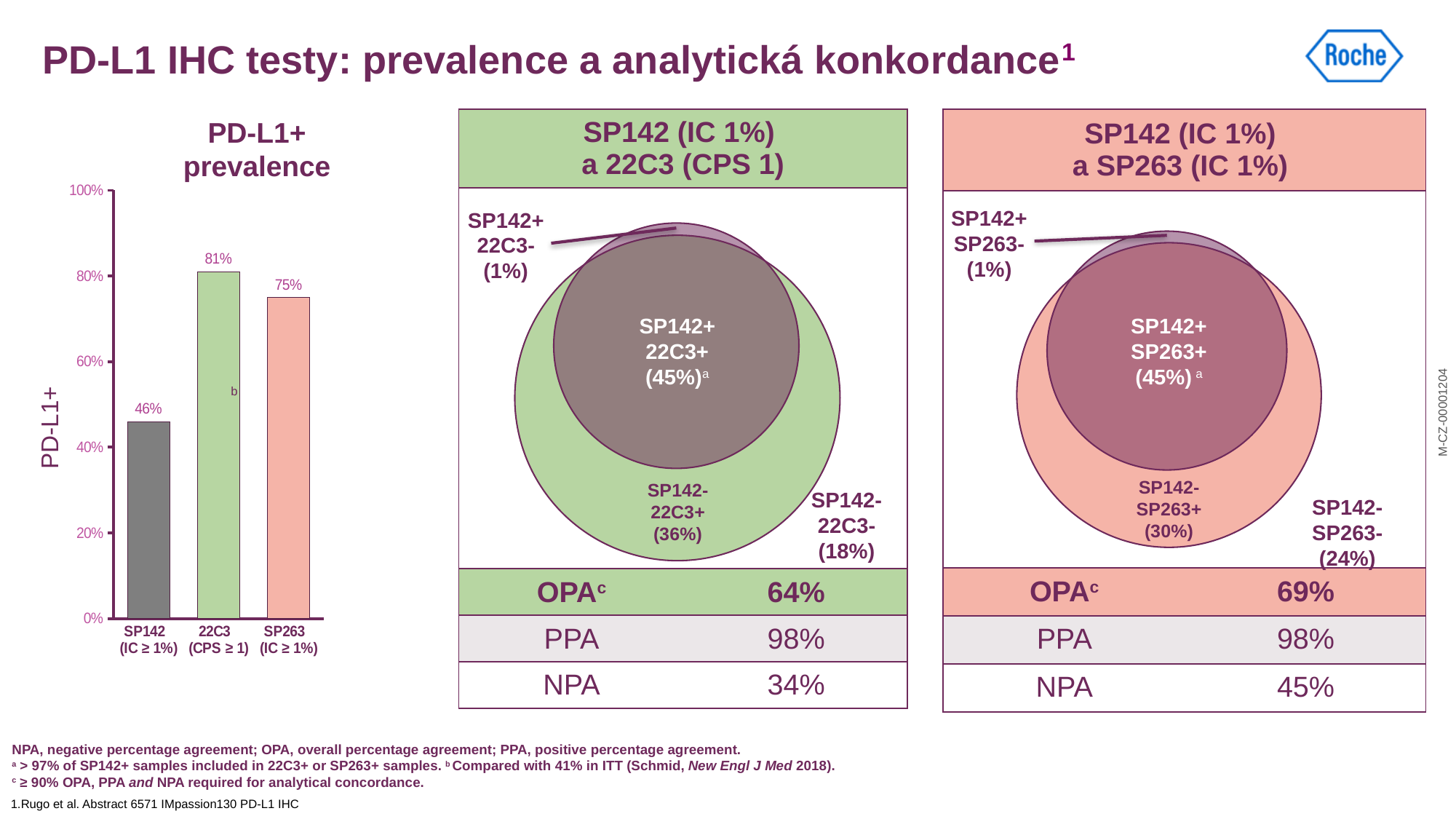
What type of chart is the PD-L1+ prevalence chart on the left of the slide? bar chart In the PD-L1+ prevalence bar chart, is the value for SP142 greater or less than 60%? less In the PD-L1+ prevalence bar chart, what is the value for SP263 (IC ≥ 1%)? 75% In the PD-L1+ prevalence bar chart, what is the value for SP142 (IC ≥ 1%)? 46% In the PD-L1+ prevalence bar chart, which assay has the highest PD-L1+ prevalence? 22C3 (CPS ≥ 1) How many bars are shown in the PD-L1+ prevalence bar chart? 3 In the PD-L1+ prevalence bar chart, what is the difference between the 22C3 and SP142 values? 35% In the PD-L1+ prevalence bar chart, what is the difference between the SP263 and SP142 values? 29% In the PD-L1+ prevalence bar chart, what is the value for 22C3 (CPS ≥ 1)? 81% In the PD-L1+ prevalence bar chart, which assay has the lowest PD-L1+ prevalence? SP142 (IC ≥ 1%) In the PD-L1+ prevalence bar chart, which is larger, the value for 22C3 or the value for SP263? 22C3 What is the y-axis label of the PD-L1+ prevalence bar chart? PD-L1+